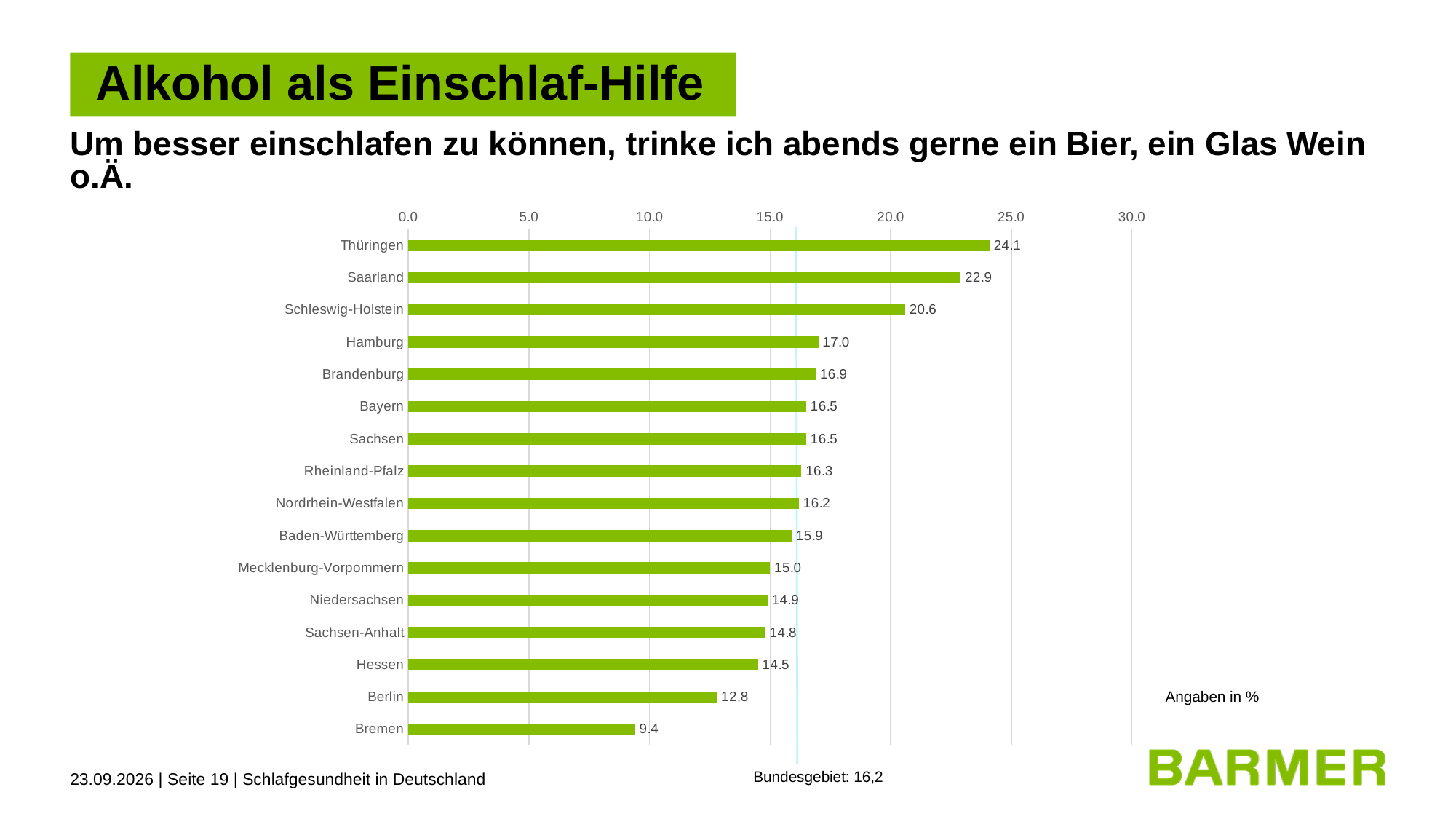
Which has a larger value, Schleswig-Holstein or Hessen? Schleswig-Holstein Which federal state has the highest value? Thüringen How many federal states are shown in the chart? 16 What is the value for Hamburg? 17.0 What is the value for Bremen? 9.4 What kind of chart is shown on the slide? Bar chart Which federal state has the lowest value? Bremen What is the difference between the values for Berlin and Bremen? 3.4 What is the value for Thüringen? 24.1 What is the difference between the values for Thüringen and Saarland? 1.2 What is the value for Mecklenburg-Vorpommern? 15.0 What value is given for the Bundesgebiet below the chart? 16,2